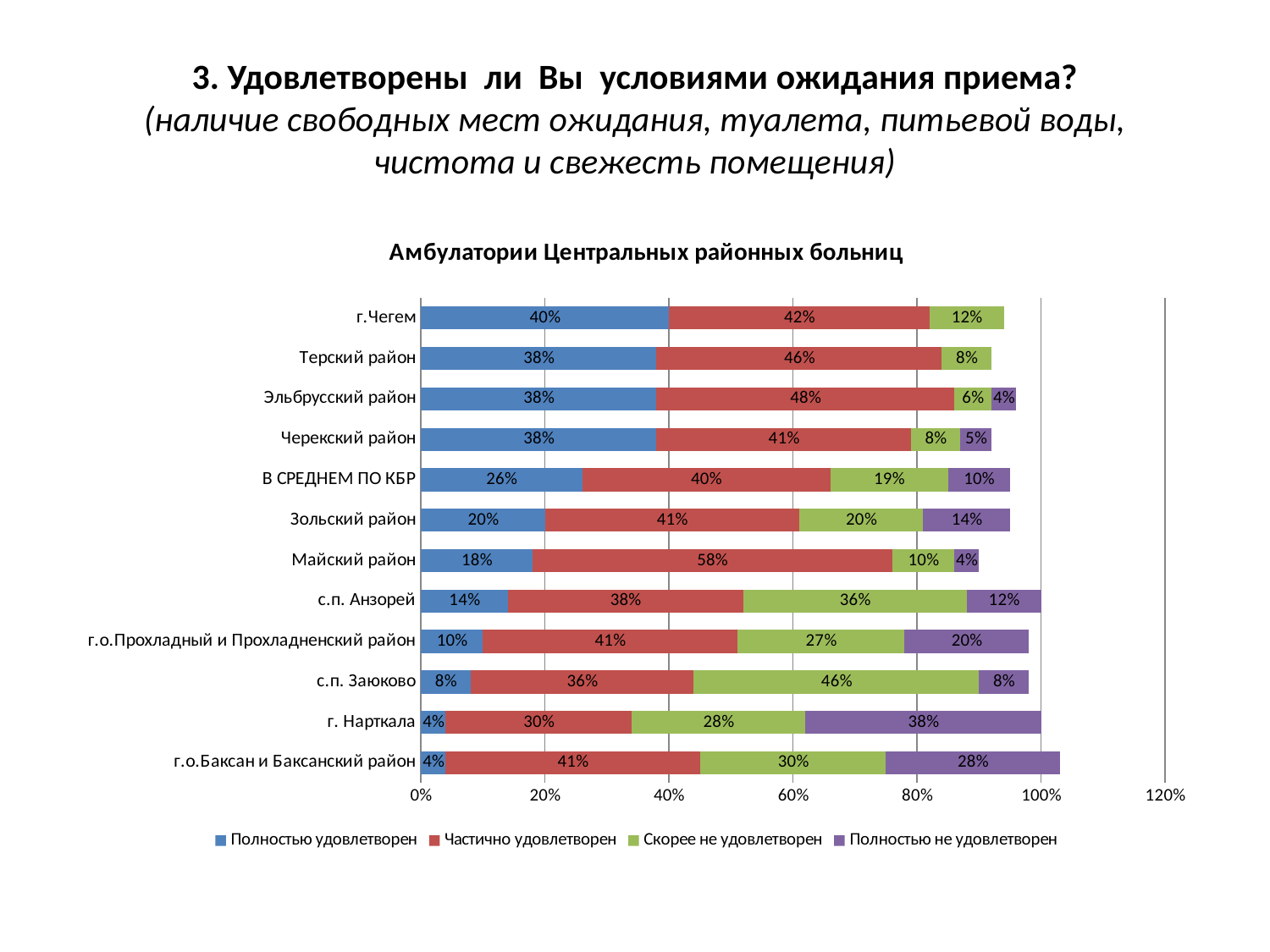
How many series does the legend list? 4 How many categories are shown on the y axis of the chart? 12 What percentage of respondents in Майский район were 'Частично удовлетворен'? 58% What is the 'Полностью удовлетворен' value for В СРЕДНЕМ ПО КБР? 26% Which category has the highest 'Полностью удовлетворен' value? г.Чегем Which is larger: the 'Скорее не удовлетворен' value for с.п. Анзорей or for Зольский район? с.п. Анзорей What is the 'Скорее не удовлетворен' value for с.п. Заюково? 46% What is the difference between the 'Частично удовлетворен' values for Майский район and г.Чегем? 16 percentage points Which category has the highest 'Частично удовлетворен' value? Майский район What is the total of the stacked bar for Эльбрусский район? 96% What is the 'Полностью не удовлетворен' value for г. Нарткала? 38% Which category has the highest 'Полностью не удовлетворен' value? г. Нарткала